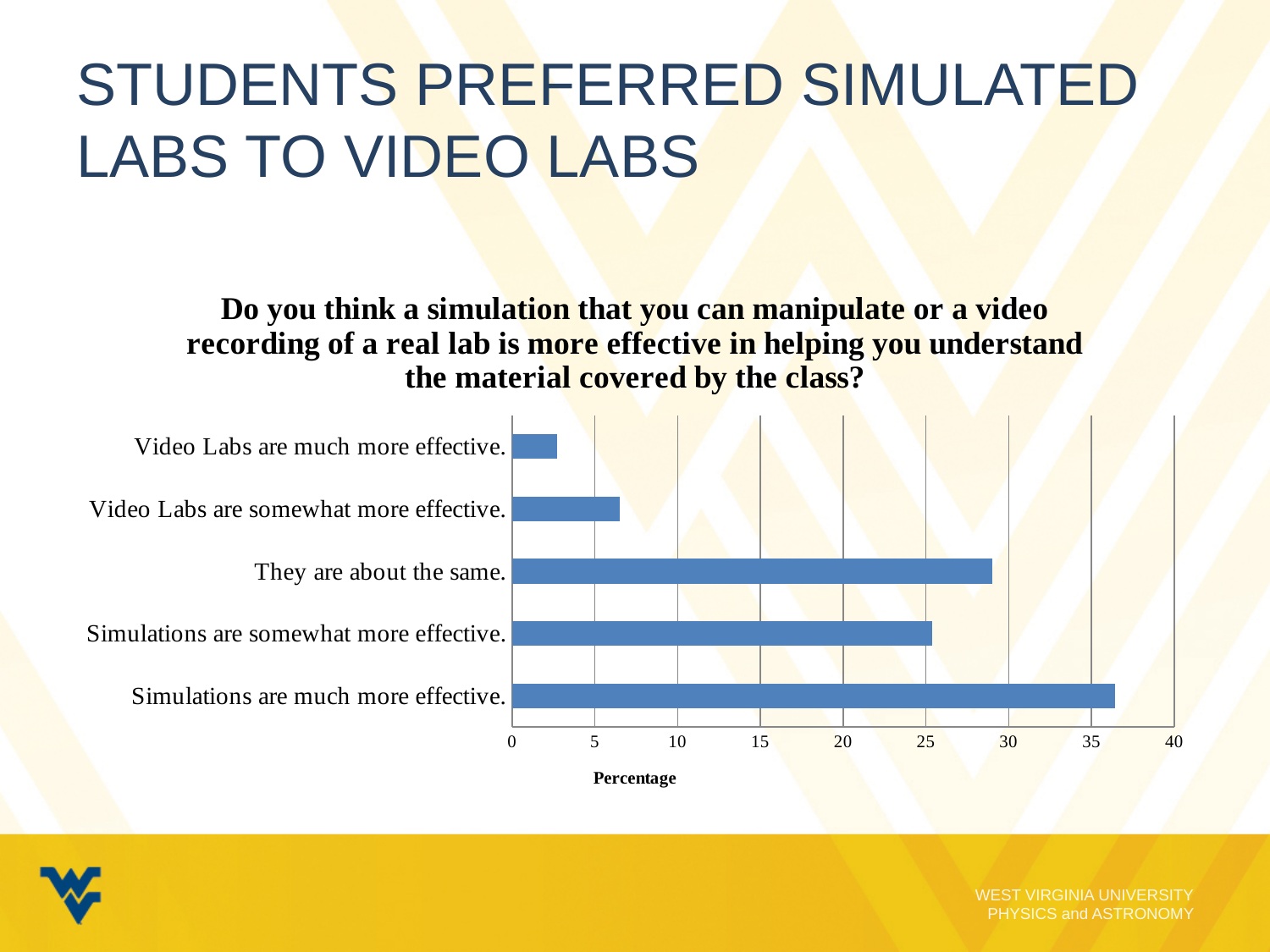
Is the value for "Video Labs are somewhat more effective." greater or less than 10? less How many response categories are plotted in the chart? 5 Which is larger: the percentage for "Video Labs are somewhat more effective." or for "Video Labs are much more effective."? Video Labs are somewhat more effective. Is the value for "Simulations are much more effective." greater or less than 35? greater Is the value for "They are about the same." greater or less than 25? greater Which response category has the highest percentage? Simulations are much more effective. What kind of chart is shown on the slide? bar chart Which is larger: the percentage for "They are about the same." or for "Simulations are somewhat more effective."? They are about the same. What is the maximum value shown on the horizontal axis of the chart? 40 Which response category has the lowest percentage? Video Labs are much more effective. What is the label on the horizontal axis of the chart? Percentage